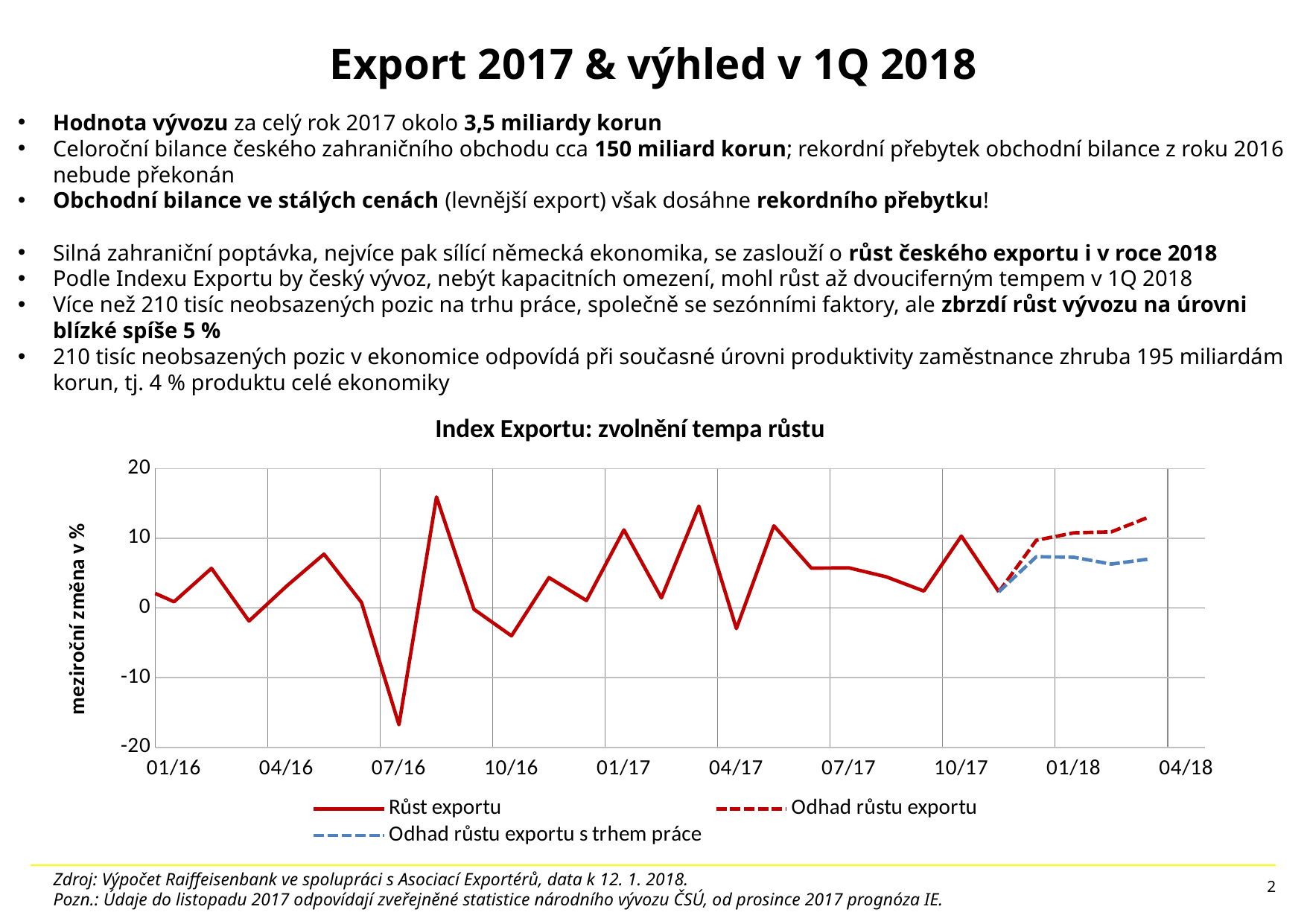
How many tick labels are shown on the horizontal axis of the chart? 10 Is the value of Růst exportu at 07/17 greater or less than 10? less At the last plotted point, which series is higher: Odhad růstu exportu or Odhad růstu exportu s trhem práce? Odhad růstu exportu What is the title of the chart? Index Exportu: zvolnění tempa růstu What is the label of the vertical axis of the chart? meziroční změna v % Is the value of Růst exportu at 10/16 greater or less than 0? less How many series does the legend of the chart list? 3 Is the value of Růst exportu at 04/17 greater or less than 0? less Does the Odhad růstu exportu series rise or fall from its first point to its last point? rise What kind of chart is shown on the slide? line chart